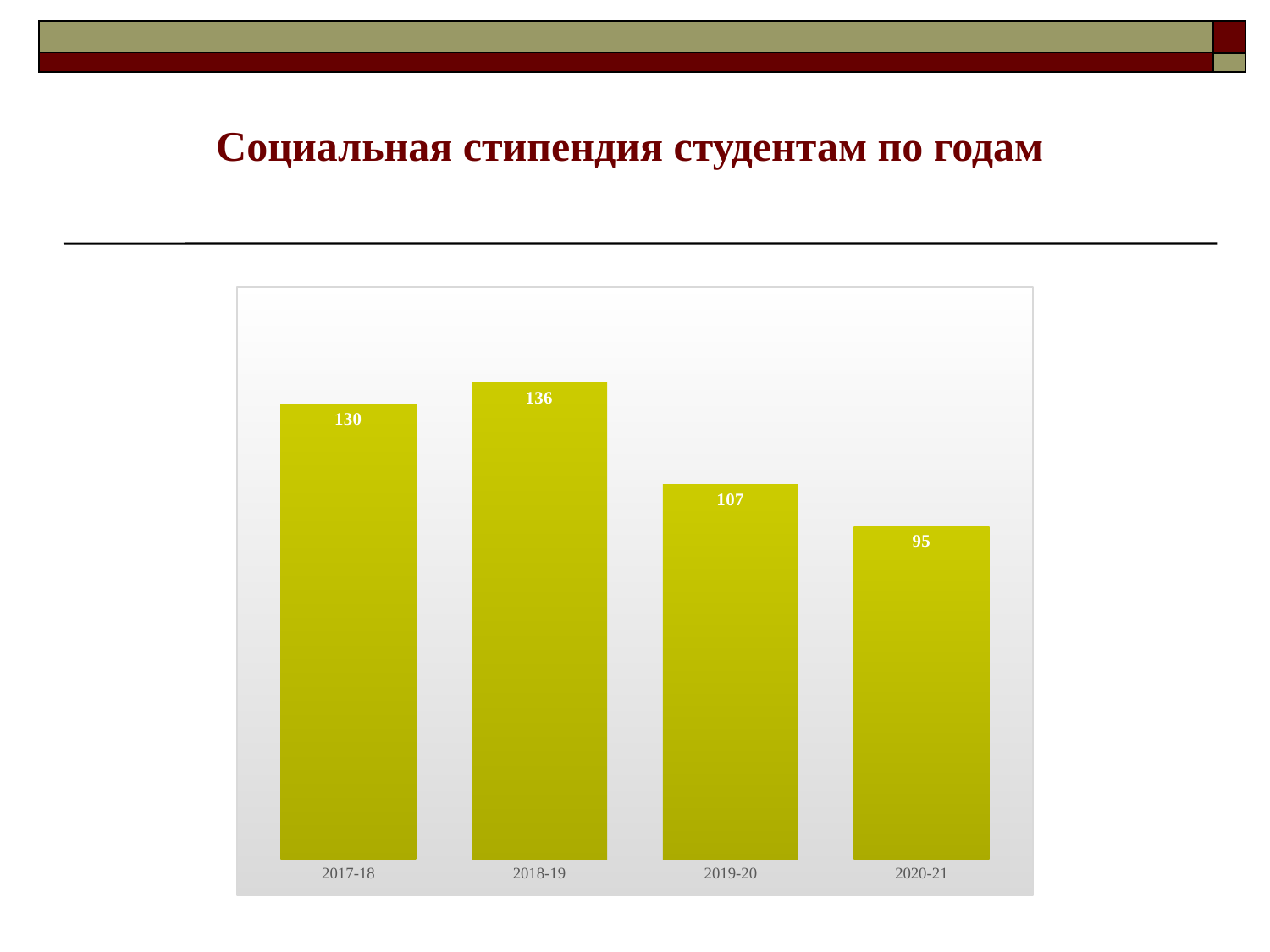
What kind of chart is shown on the slide? bar chart What is the value for 2019-20? 107 Which is larger, the value for 2017-18 or the value for 2019-20? 2017-18 What is the difference between the values for 2018-19 and 2020-21? 41 What is the value for 2017-18? 130 How many years are shown on the x axis? 4 What is the difference between the values for 2017-18 and 2019-20? 23 What is the value for 2020-21? 95 What is the title of the slide? Социальная стипендия студентам по годам What is the value for 2018-19? 136 Which year has the highest value? 2018-19 Which year has the lowest value? 2020-21